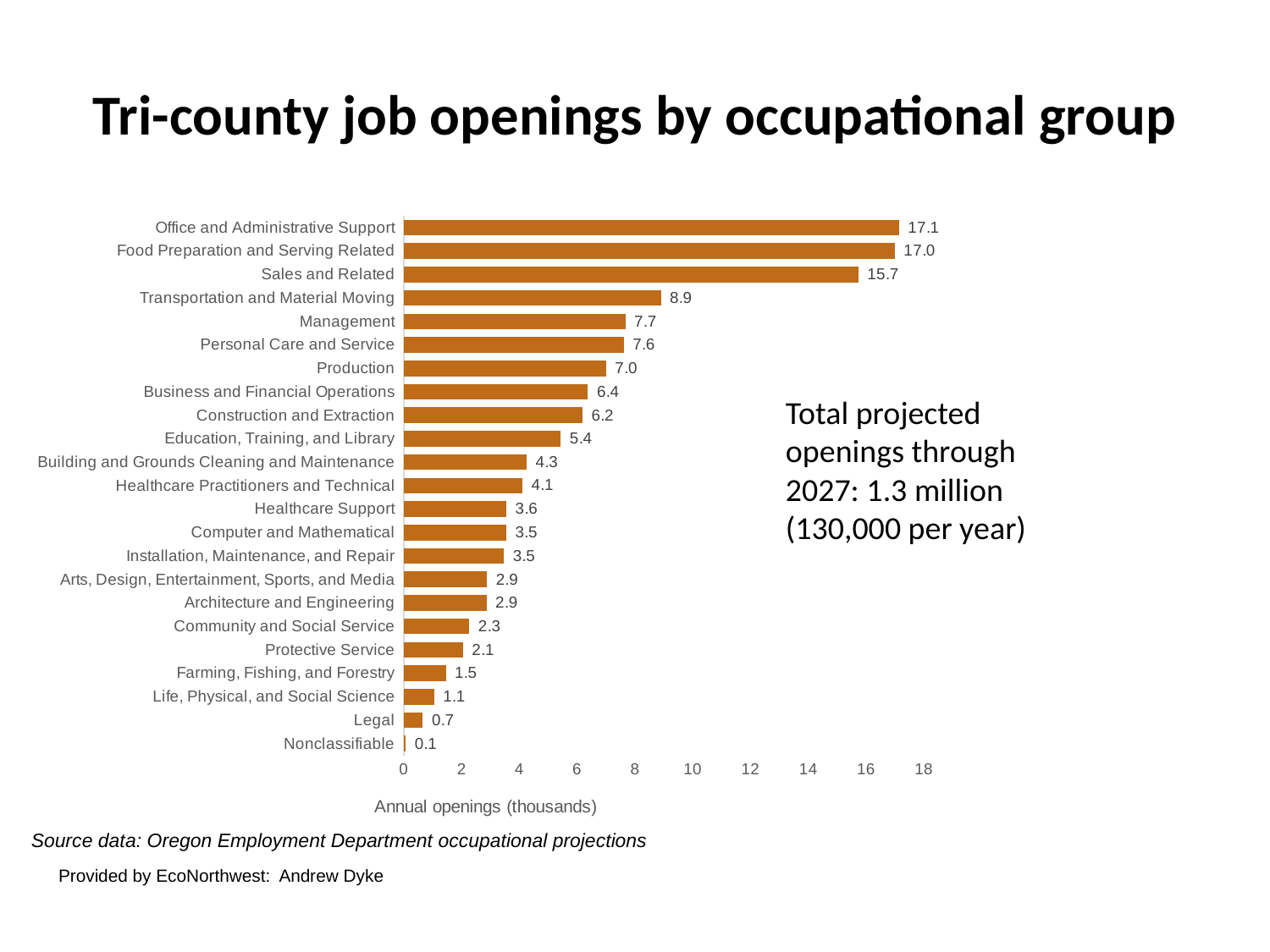
What is the value for Construction and Extraction? 6.2 Which is larger, Transportation and Material Moving or Management? Transportation and Material Moving What is the x-axis label of the chart? Annual openings (thousands) What is the difference between Office and Administrative Support and Sales and Related? 1.4 What kind of chart is shown on the slide? bar chart Is the value for Production greater or less than 8? less What is the title of the chart? Tri-county job openings by occupational group What is the value for Legal? 0.7 What is the value for Sales and Related? 15.7 How many occupational groups are shown in the chart? 23 Which occupational group has the highest annual openings? Office and Administrative Support Which occupational group has the lowest annual openings? Nonclassifiable